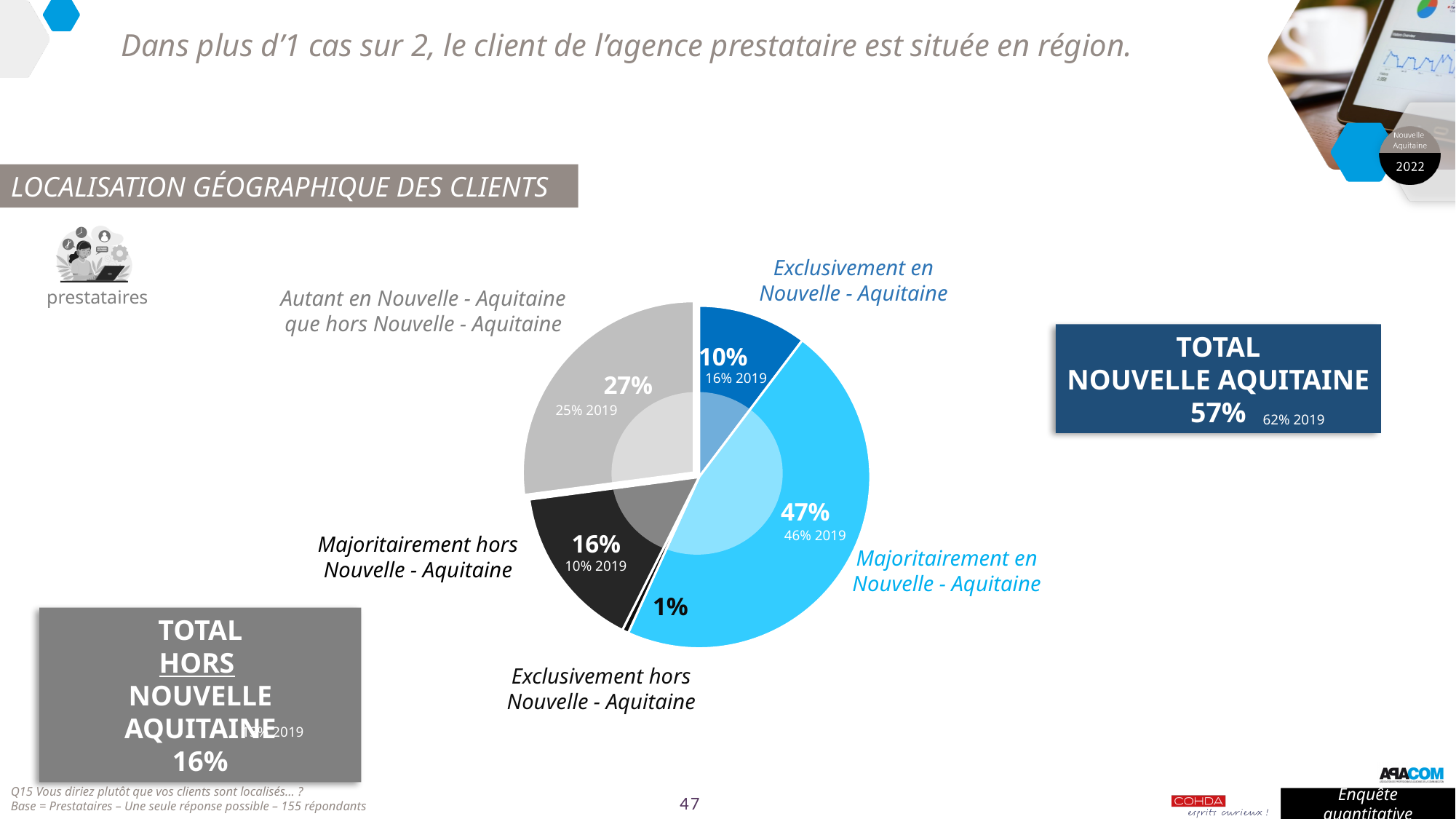
What is the value shown in the "TOTAL NOUVELLE AQUITAINE" box? 57% What share of the pie is labelled "Majoritairement hors Nouvelle - Aquitaine"? 16% What was the 2019 value shown for "Majoritairement hors Nouvelle - Aquitaine"? 10% What share of the pie is labelled "Exclusivement hors Nouvelle - Aquitaine"? 1% What is the difference between the "Majoritairement en Nouvelle - Aquitaine" slice and the "Autant en Nouvelle - Aquitaine que hors Nouvelle - Aquitaine" slice? 20% How many slices does the pie chart have? 5 What share of the pie is labelled "Exclusivement en Nouvelle - Aquitaine"? 10% What share of the pie is labelled "Autant en Nouvelle - Aquitaine que hors Nouvelle - Aquitaine"? 27% Which slice of the pie is the largest? Majoritairement en Nouvelle - Aquitaine Which slice of the pie is the smallest? Exclusivement hors Nouvelle - Aquitaine What share of the pie is labelled "Majoritairement en Nouvelle - Aquitaine"? 47% What kind of chart is shown on the slide? pie chart